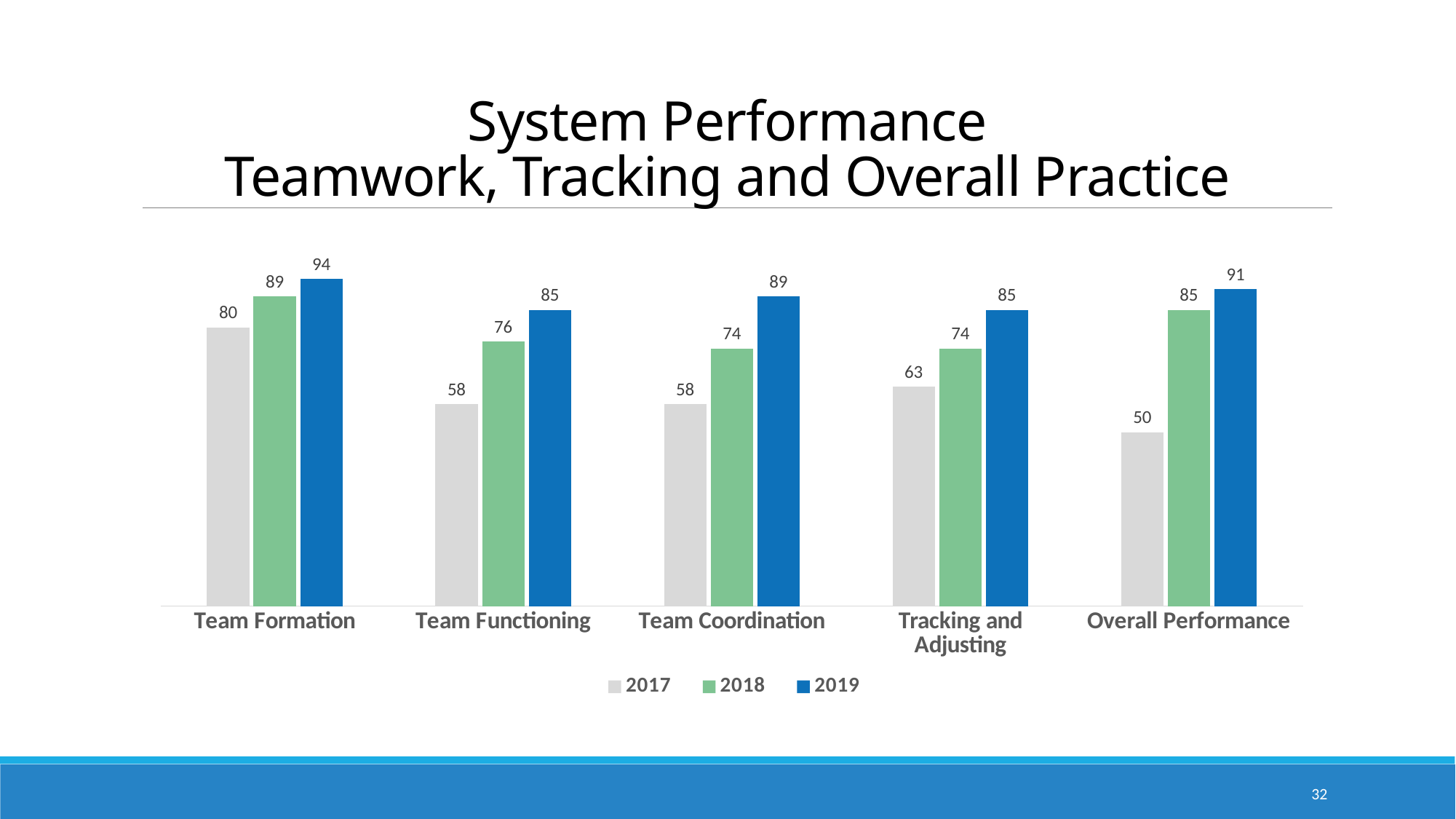
How many categories are shown on the x axis? 5 What is the 2019 value for Team Formation? 94 Which category has the highest 2019 value? Team Formation How many series does the legend list? 3 Which category has the lowest 2017 value? Overall Performance What kind of chart is shown on the slide? Bar chart What is the difference between the 2019 and 2017 values for Overall Performance? 41 What is the difference between the 2018 and 2017 values for Team Functioning? 18 Which is larger, the 2018 value for Team Formation or the 2018 value for Team Coordination? Team Formation What is the 2017 value for Overall Performance? 50 What is the 2018 value for Tracking and Adjusting? 74 Which colour represents the 2019 series in the legend? Blue